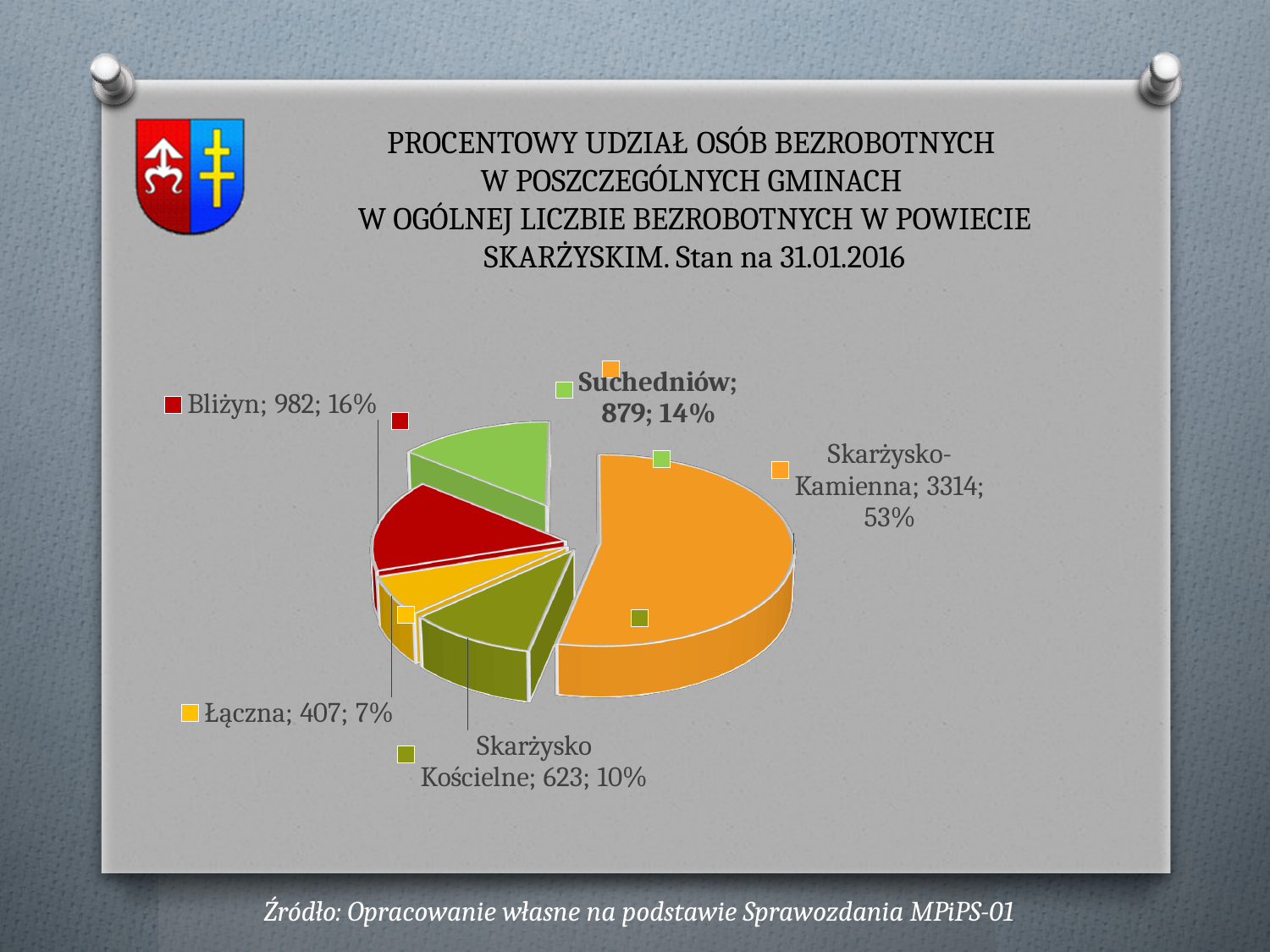
Which gmina has the largest share of the pie? Skarżysko-Kamienna What is the value shown for Skarżysko Kościelne? 623 Which is larger, the value for Skarżysko Kościelne or the value for Łączna? Skarżysko Kościelne What date is given in the chart title as the status date of the data? 31.01.2016 What percentage share is shown for Bliżyn? 16% What percentage share is shown for Łączna? 7% Which gmina has the smallest share of the pie? Łączna What is the difference between the values for Bliżyn and Suchedniów? 103 What is the value shown for Skarżysko-Kamienna? 3314 What kind of chart is shown on the slide? pie chart How many slices does the pie chart have? 5 What is the value shown for Suchedniów? 879